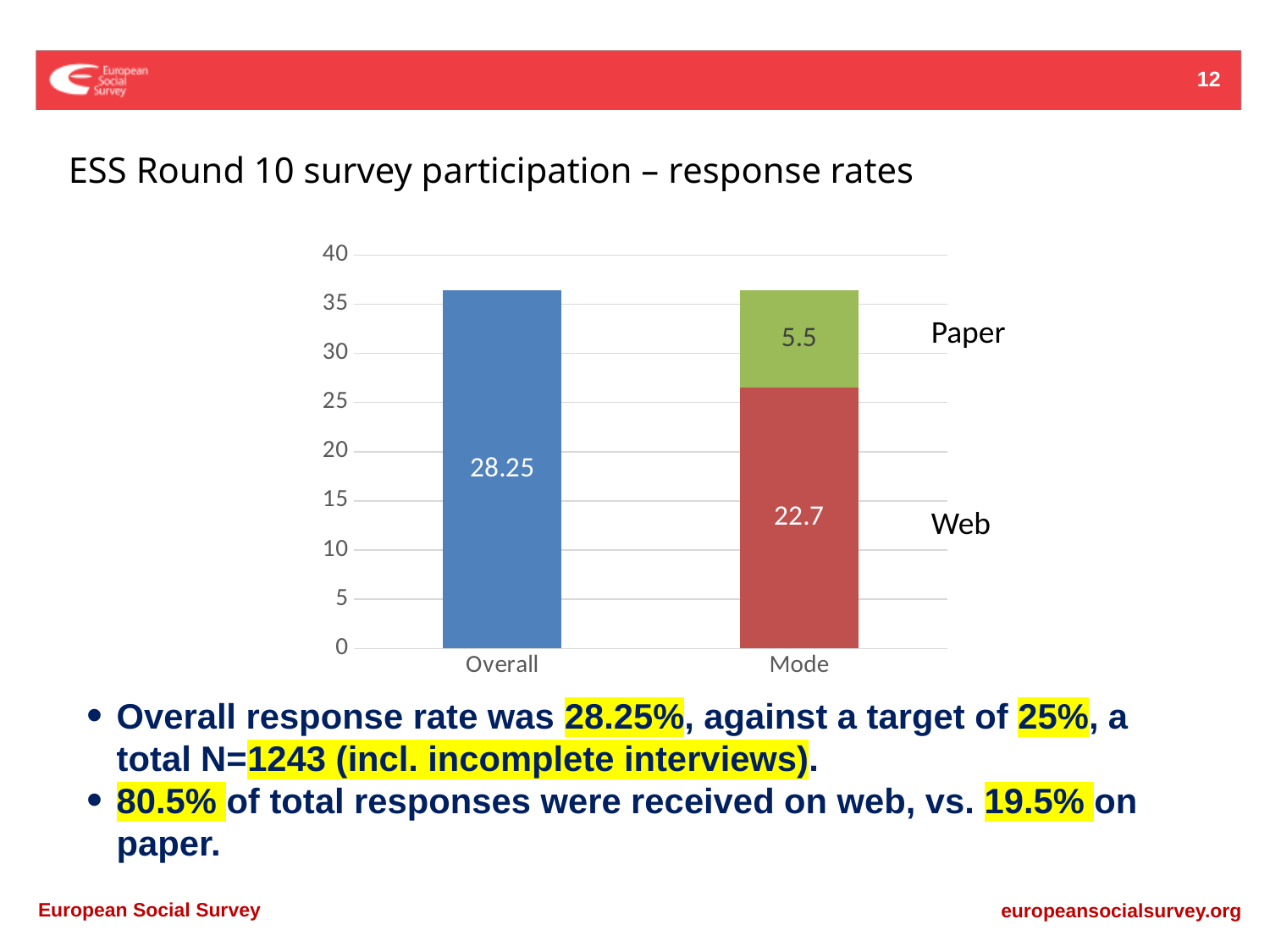
What is the total of the stacked Mode bar (Web plus Paper)? 28.2 Which segment of the Mode bar is larger, Web or Paper? Web What is the difference between the Web value and the Paper value in the Mode bar? 17.2 What colour is the Paper segment of the Mode bar? Green What is the difference between the Overall value and the Web value? 5.55 What is the value shown for the Overall bar? 28.25 What is the value of the Paper segment in the Mode bar? 5.5 What kind of chart is shown on the slide? Bar chart Which labelled value on the chart is the largest? Overall (28.25) How many categories are shown on the x axis? 2 Which labelled value on the chart is the smallest? Paper (5.5) What is the value of the Web segment in the Mode bar? 22.7